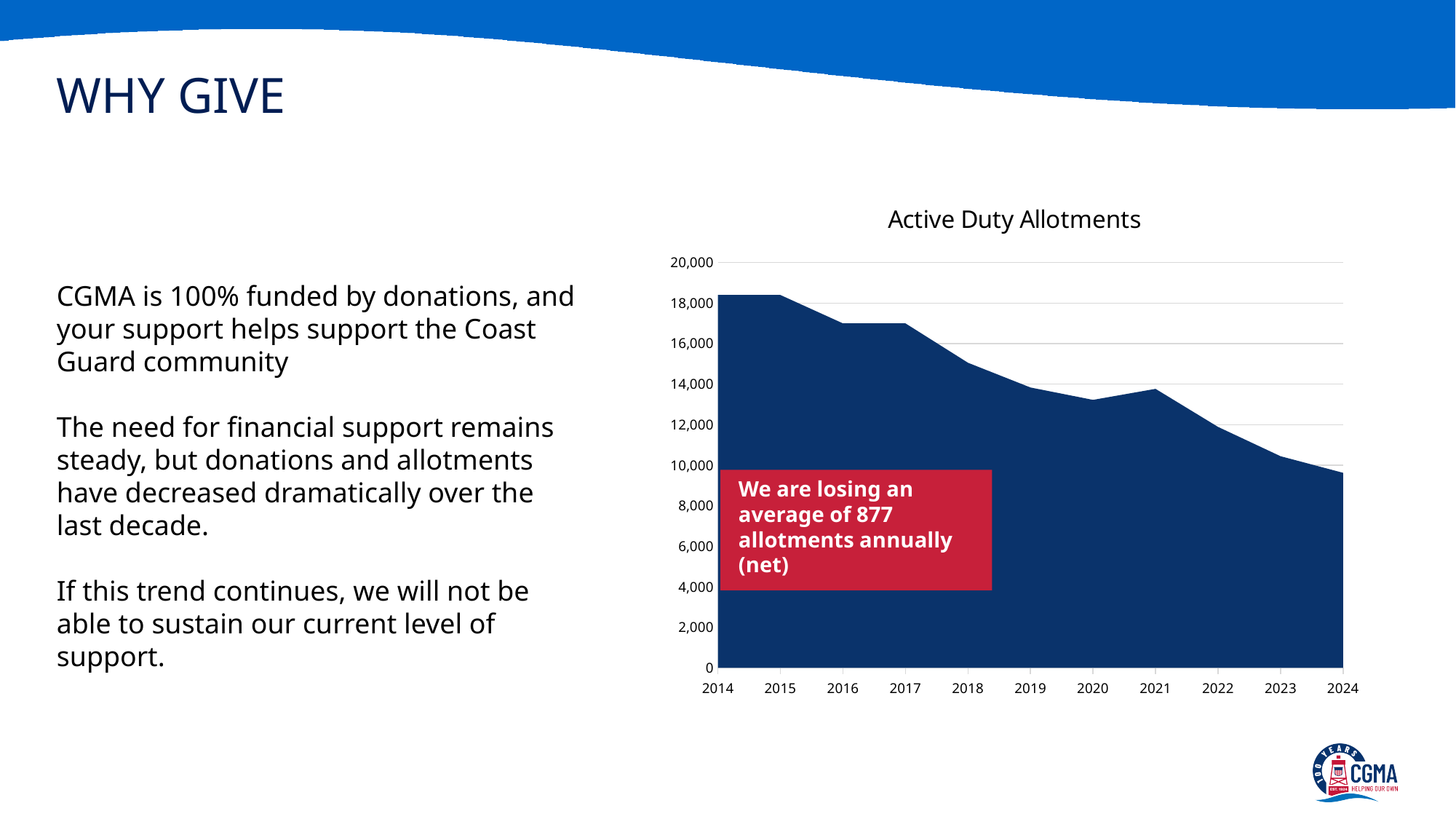
Is the value for 2018 greater or less than 16,000? less Is the value for 2022 greater or less than 10,000? greater Do the Active Duty Allotments values rise or fall from 2014 to 2024? fall Is the value for 2014 greater or less than 16,000? greater According to the annotation on the chart, how many allotments are being lost on average annually (net)? 877 What kind of chart is shown on the slide? area chart Which year has the lowest value for Active Duty Allotments? 2024 How many years are plotted on the x axis of the chart? 11 Which year has the larger value, 2018 or 2021? 2018 What is the title of the chart? Active Duty Allotments